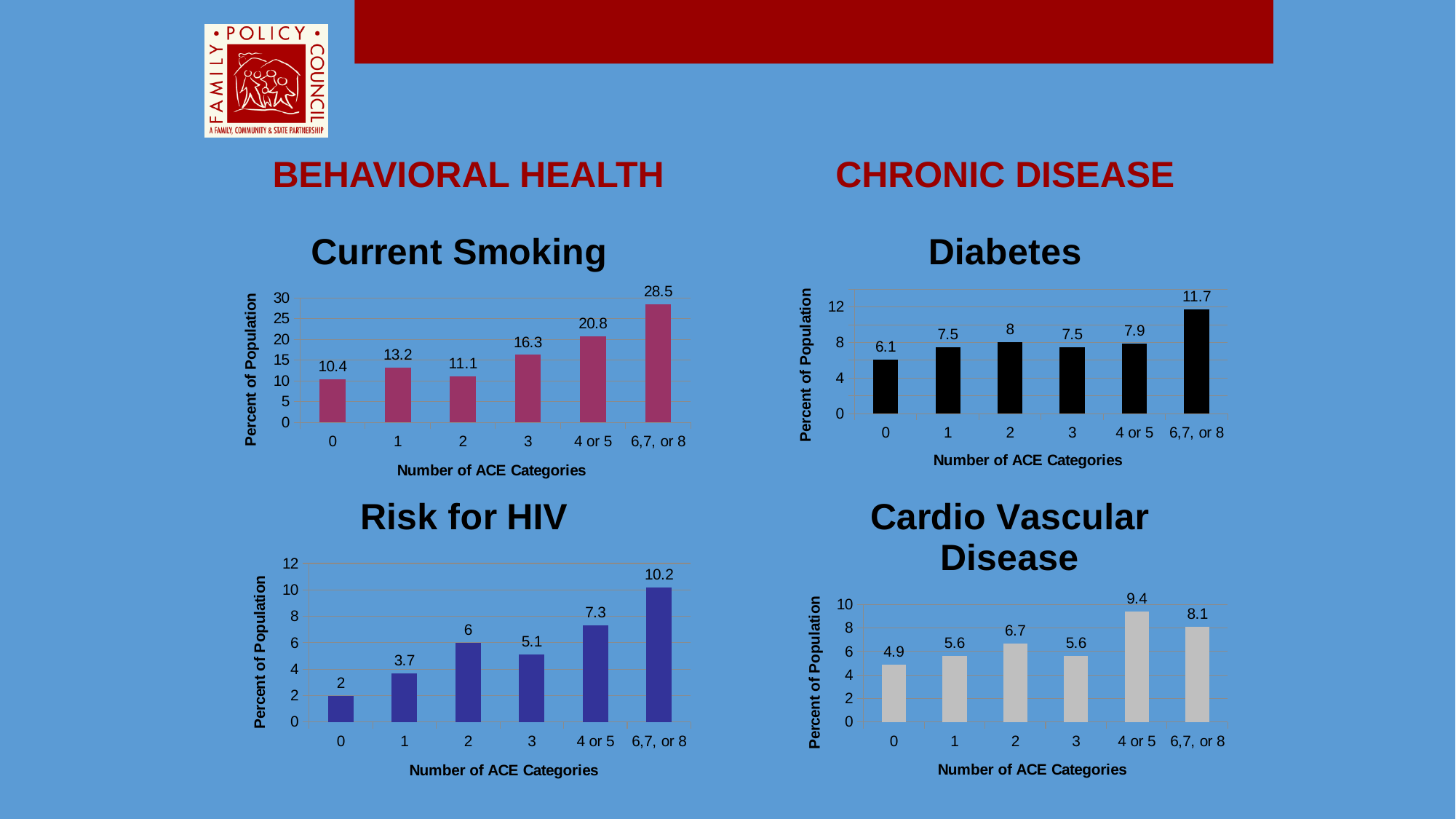
In the Diabetes chart, what is the value for 0 ACE categories? 6.1 How many ACE categories are shown on the x axis of the Diabetes chart? 6 In the Current Smoking chart, what is the difference between the values for 6,7, or 8 and 0 ACE categories? 18.1 What is the y-axis label on the Cardio Vascular Disease chart? Percent of Population In the Current Smoking chart, what is the value for 4 or 5 ACE categories? 20.8 In the Cardio Vascular Disease chart, which ACE category has the highest value? 4 or 5 In the Diabetes chart, which ACE category has the lowest value? 0 In the Risk for HIV chart, what is the value for 1 ACE category? 3.7 In the Cardio Vascular Disease chart, what is the difference between the values for 4 or 5 and 6,7, or 8 ACE categories? 1.3 In the Risk for HIV chart, which is larger, the value for 2 or the value for 3 ACE categories? 2 What kind of chart is the Risk for HIV chart? Bar chart In the Current Smoking chart, which ACE category has the highest value? 6,7, or 8